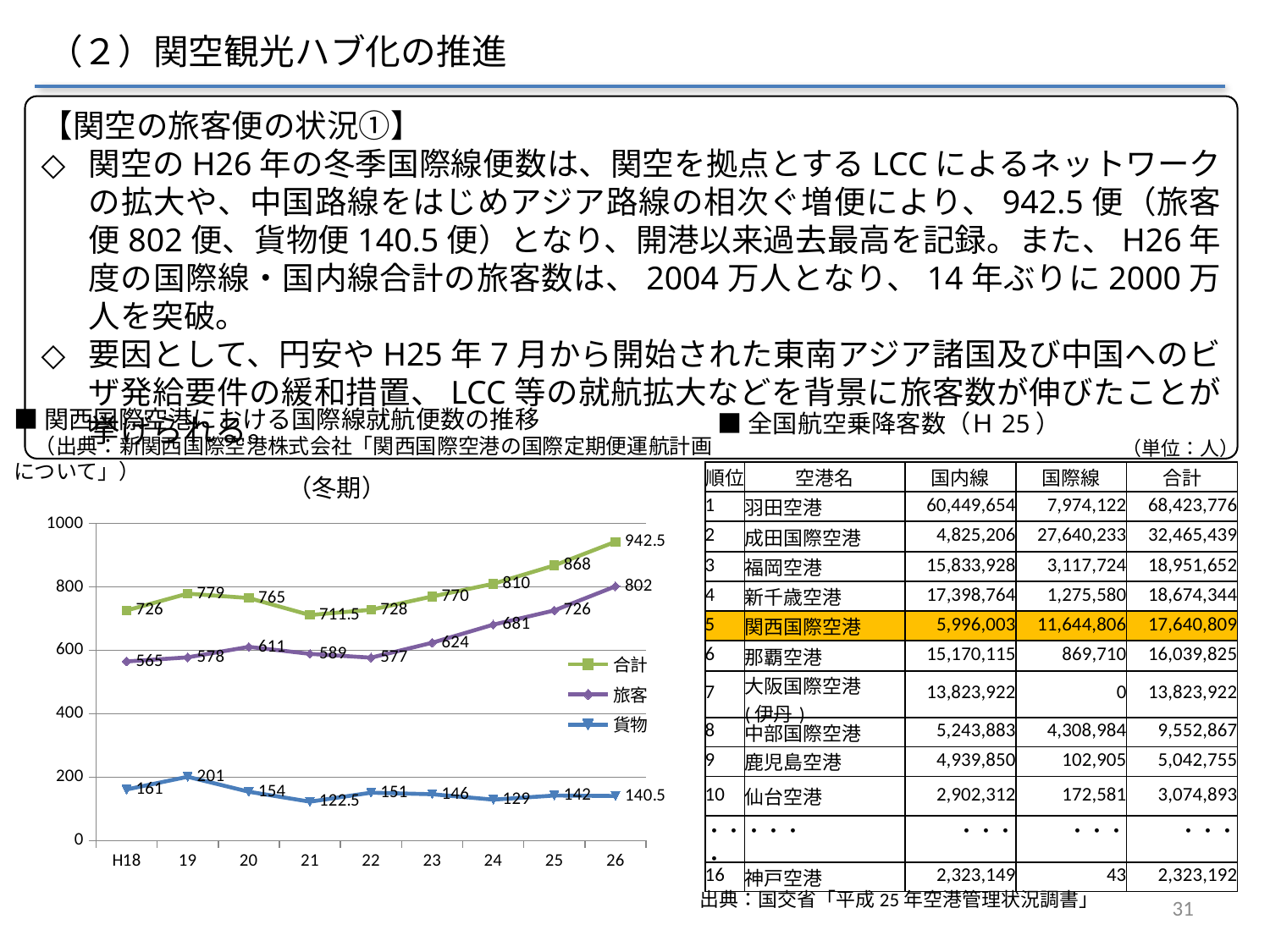
In the line chart, what is the value of 貨物 for 21? 122.5 In the line chart, which year has the lowest 貨物 value? 21 In the line chart, do the 旅客 values rise or fall from 22 to 26? Rise What is the title shown above the line chart's plot area? （冬期） In the line chart, which year has the highest 合計 value? 26 In the line chart, what is the value of 旅客 for H18? 565 In the line chart, what is the value of 合計 for 26? 942.5 In the line chart, what is the difference between the 合計 values for 26 and H18? 216.5 In the line chart, which is larger: the 旅客 value for 19 or the 旅客 value for 20? 20 What type of chart is shown on the left of the slide? Line chart How many points along the x axis does the line chart plot for each series? 9 How many series does the legend of the line chart list? 3